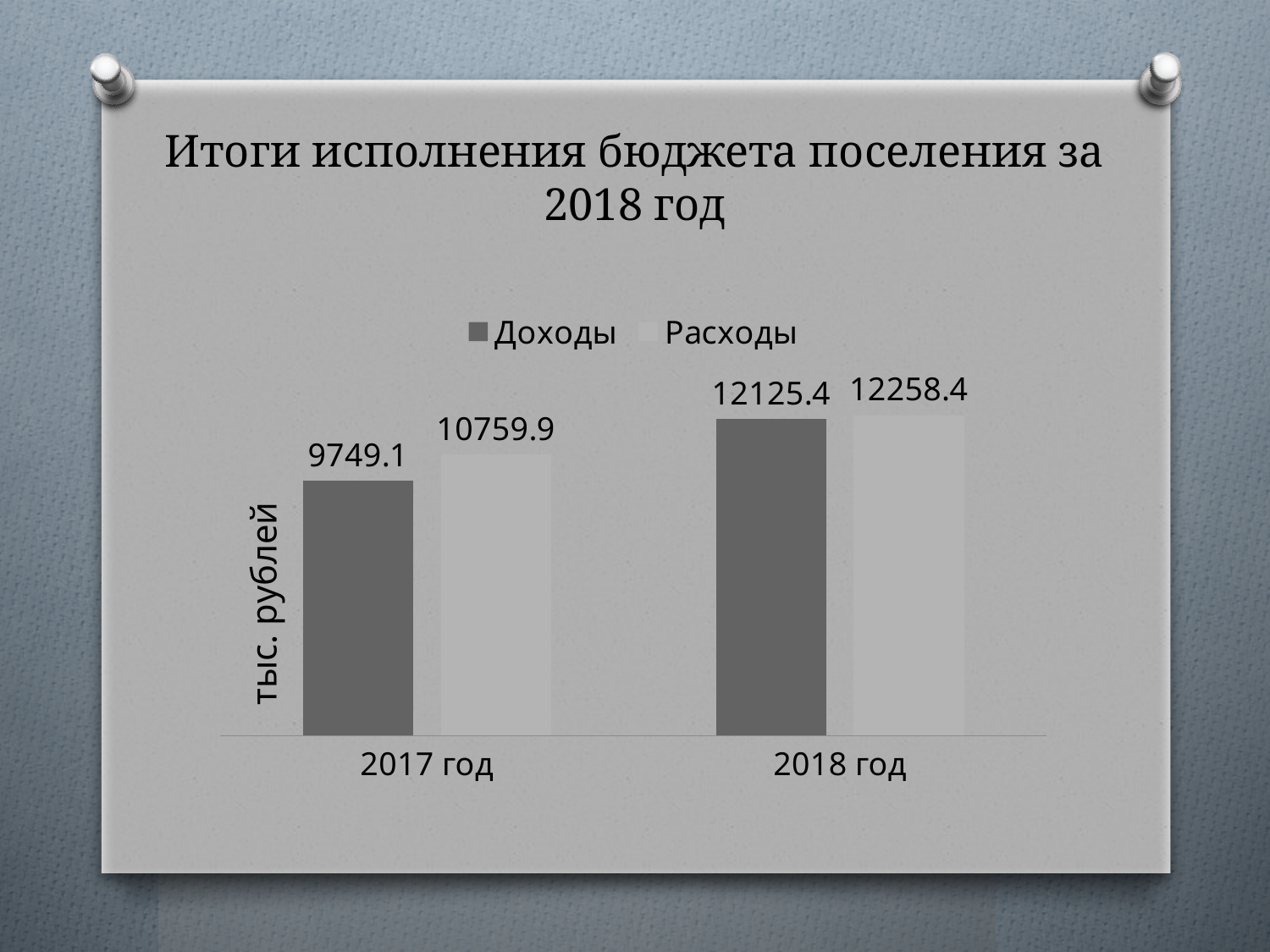
What is the value of Расходы for 2017 год? 10759.9 What is the value of Доходы for 2017 год? 9749.1 What is the value of Расходы for 2018 год? 12258.4 How many series does the legend list? 2 By how much did Доходы increase from 2017 год to 2018 год? 2376.3 What is the label of the vertical axis? тыс. рублей What kind of chart is shown on the slide? Bar chart What is the difference between Расходы and Доходы for 2017 год? 1010.8 Which is larger for 2018 год, Доходы or Расходы? Расходы Which bar has the highest value on the chart? Расходы, 2018 год What is the value of Доходы for 2018 год? 12125.4 Which bar has the lowest value on the chart? Доходы, 2017 год